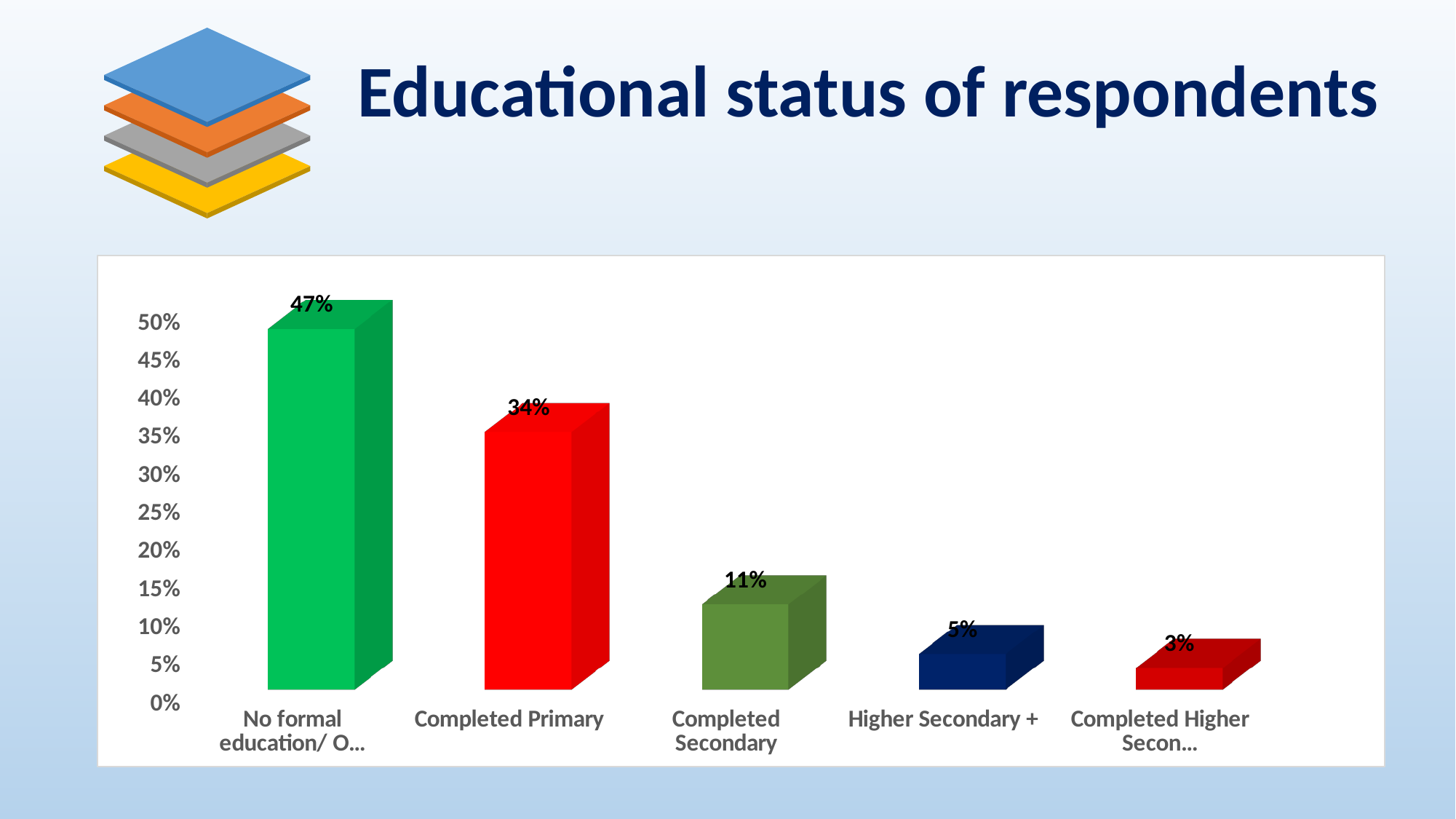
How many categories are shown on the chart? 5 Which is larger, the value for Completed Primary or the value for Completed Secondary? Completed Primary What is the value shown for the Completed Secondary category? 11% Is the value for Completed Primary greater or less than 30%? greater Which category has the lowest value? Completed Higher Secon... What percentage of respondents completed primary education? 34% What is the difference between the values for No formal education and Completed Primary? 13% What is the difference between the values for Completed Secondary and Higher Secondary +? 6% What is the value shown for the Higher Secondary + category? 5% What is the title of the slide? Educational status of respondents Which category has the highest value? No formal education/ O... What kind of chart is shown on the slide? Bar chart